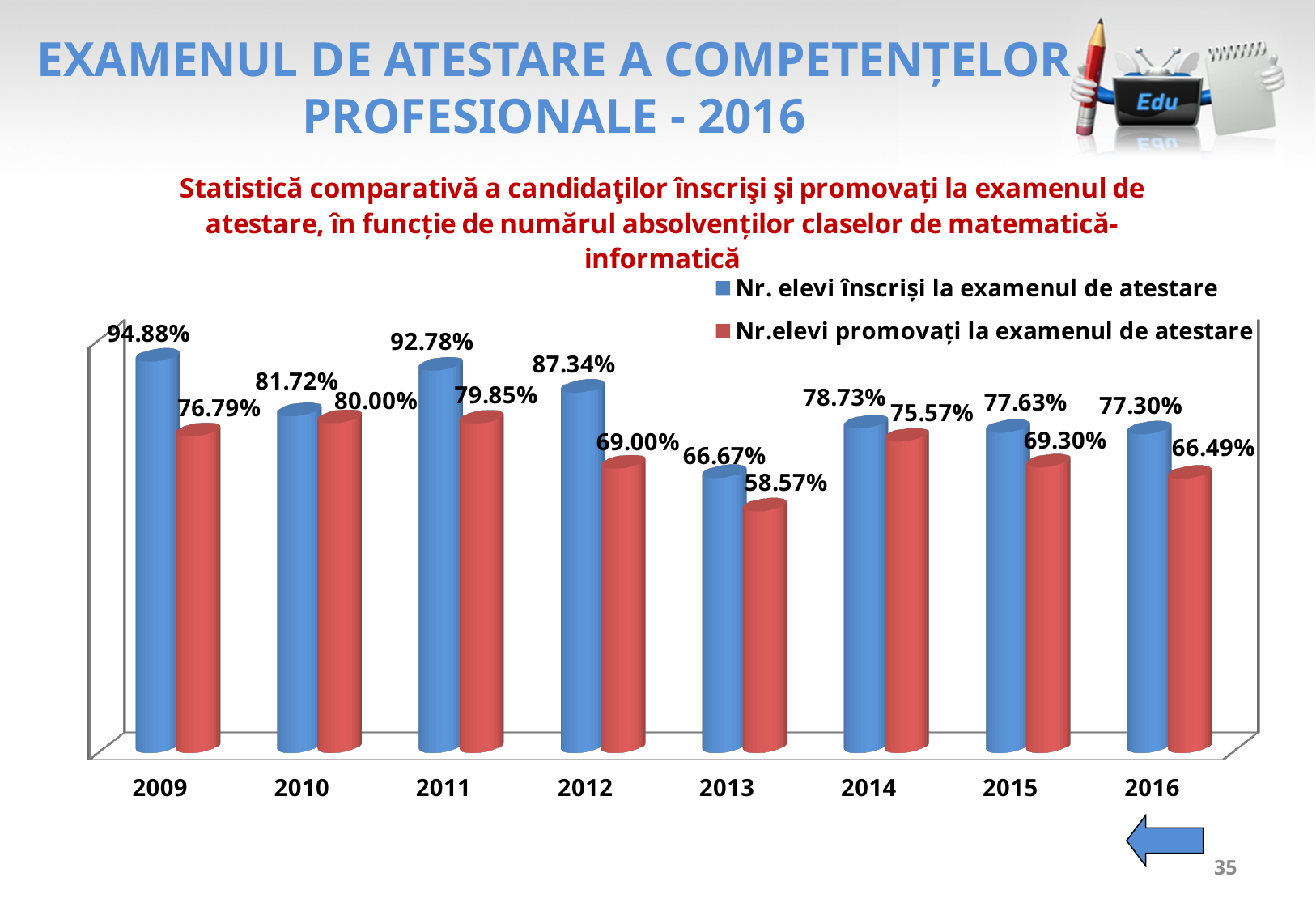
How many series does the legend list? 2 What is the value for 'Nr.elevi promovați la examenul de atestare' in 2016? 66.49% What is the difference between the 'Nr. elevi înscriși' value and the 'Nr.elevi promovați' value in 2010? 1.72% What is the value for 'Nr.elevi promovați la examenul de atestare' in 2013? 58.57% In which year is the value for 'Nr. elevi înscriși la examenul de atestare' the highest? 2009 What is the value for 'Nr. elevi înscriși la examenul de atestare' in 2009? 94.88% Which is larger: the 'Nr.elevi promovați' value in 2014 or in 2015? 2014 In which year is the value for 'Nr.elevi promovați la examenul de atestare' the lowest? 2013 Which colour represents 'Nr.elevi promovați la examenul de atestare' in the legend? Red What is the difference between the 'Nr. elevi înscriși' value and the 'Nr.elevi promovați' value in 2012? 18.34% How many years are shown on the x axis? 8 What kind of chart is shown on the slide? Bar chart